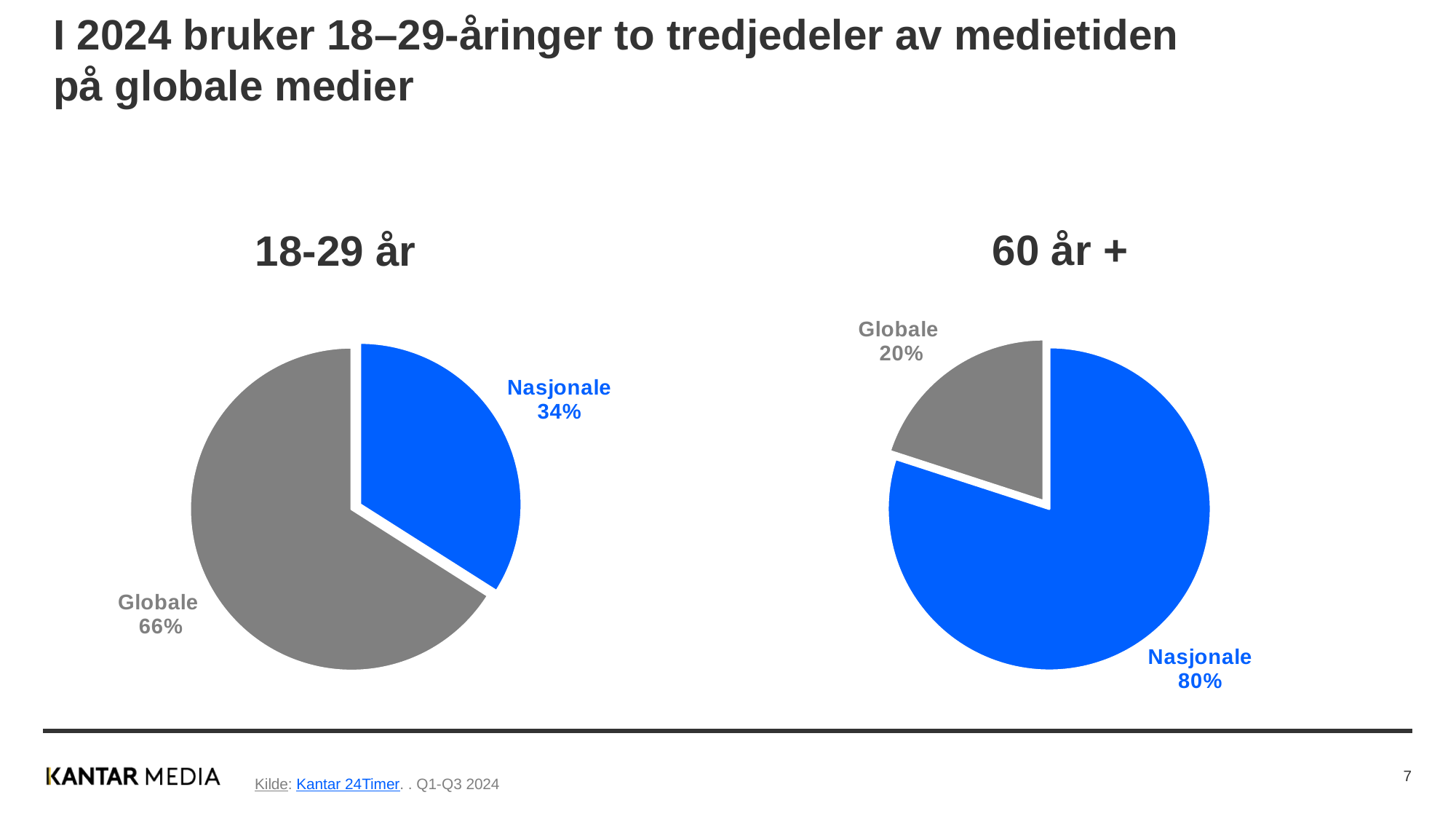
In the "18-29 år" chart, what colour is the Nasjonale slice? Blue In the "18-29 år" chart, what is the difference between the Globale and Nasjonale shares? 32% In the "60 år +" chart, what is the difference between the Nasjonale and Globale shares? 60% In the "18-29 år" chart, which slice is the largest? Globale In the "60 år +" chart, what is the value for Globale? 20% In the "18-29 år" chart, what is the value for Nasjonale? 34% In the "18-29 år" chart, what share of media time goes to Globale? 66% What kind of chart is used for the "60 år +" data? Pie chart In the "60 år +" chart, which slice is the smallest? Globale How many slices does the "18-29 år" pie chart have? 2 Is the Globale share larger in the "18-29 år" chart or in the "60 år +" chart? 18-29 år In the "60 år +" chart, what is the value for Nasjonale? 80%